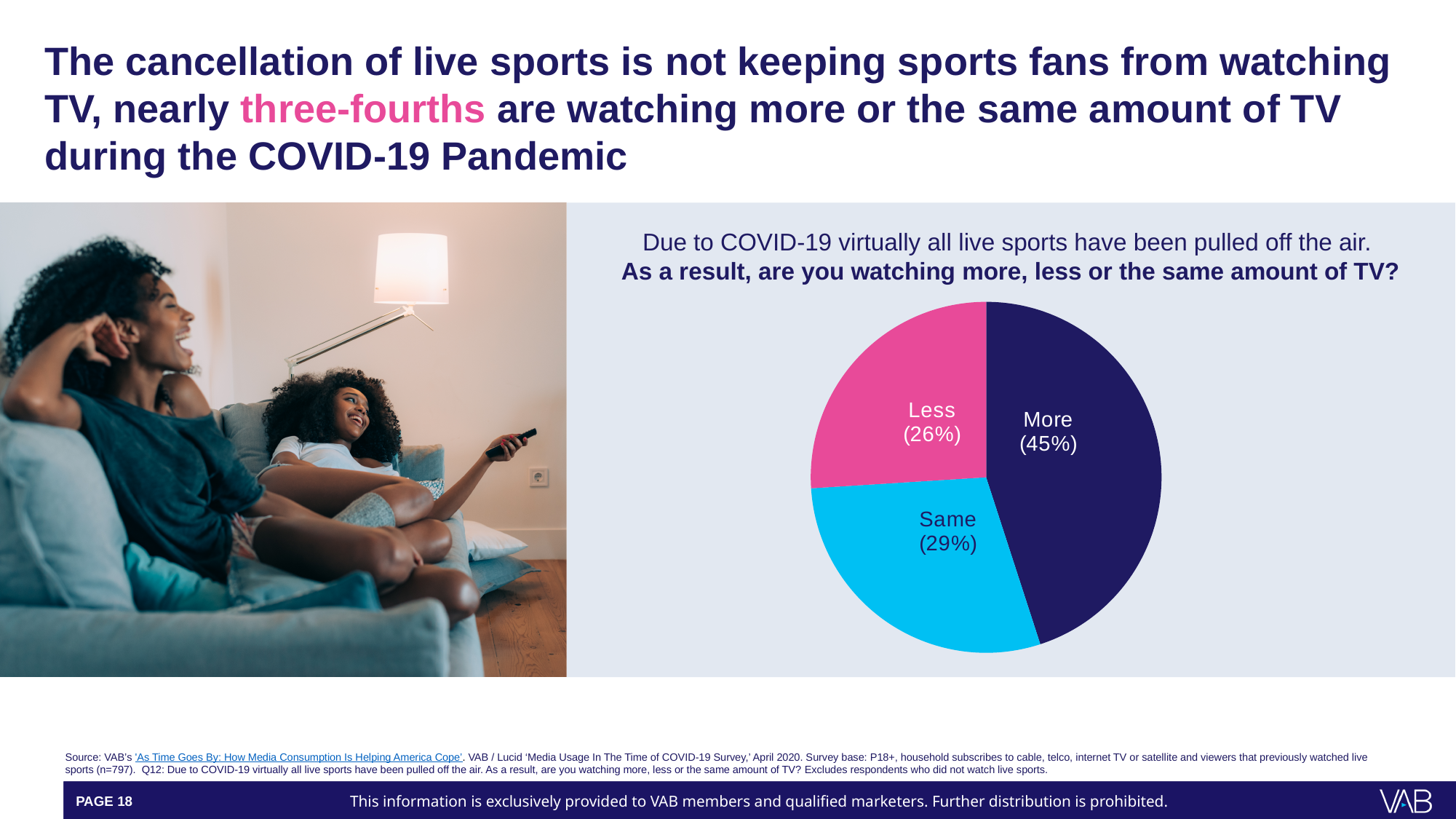
How many slices does the pie chart have? 3 What percentage of respondents say they are watching more TV? 45% What colour is the 'Less' slice of the pie chart? Pink What is the combined share of respondents watching more or the same amount of TV? 74% Which response has the largest share of the pie? More What percentage of respondents say they are watching the same amount of TV? 29% What percentage of respondents say they are watching less TV? 26% What type of chart is shown on the slide? Pie chart What is the difference in percentage points between the 'Same' and 'Less' slices? 3 Which response has the smallest share of the pie? Less Which slice is larger, 'Same' or 'Less'? Same What is the difference in percentage points between the 'More' and 'Less' slices? 19